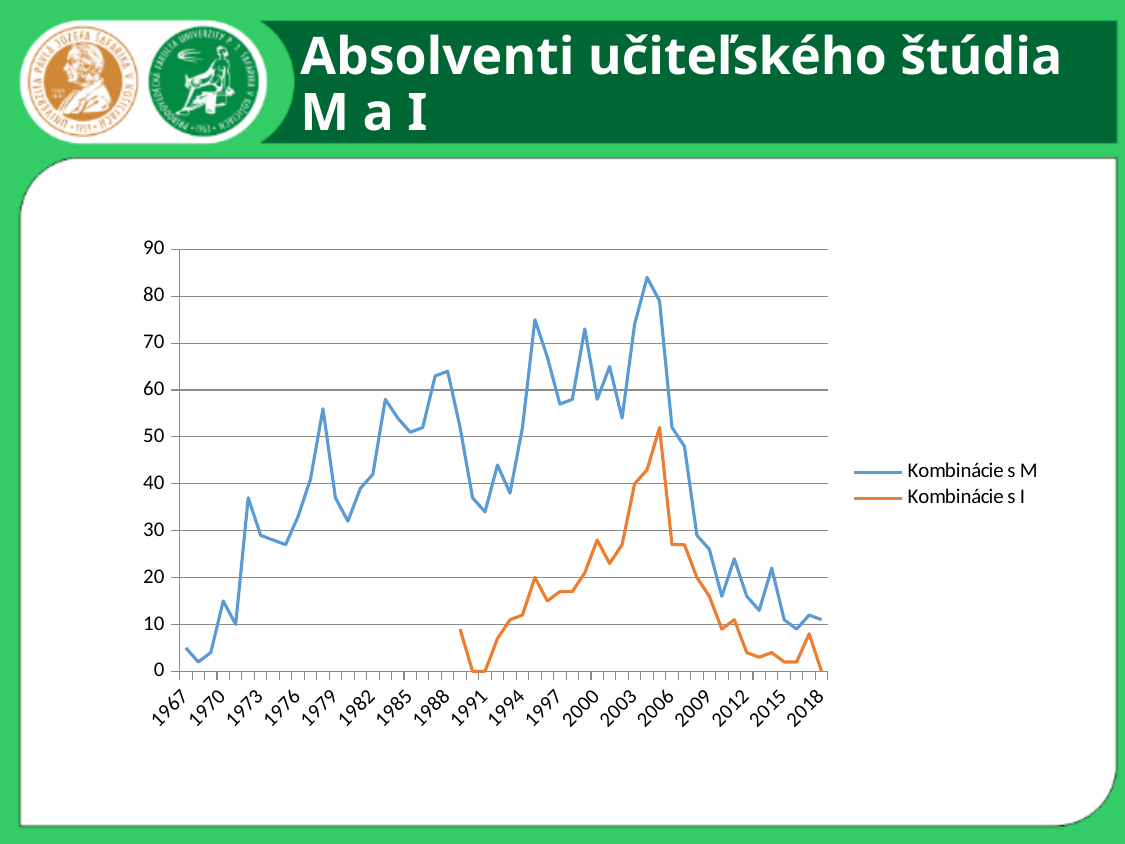
Does the Kombinácie s I series generally rise or fall between 1991 and 2005? rise What are the two series named in the legend? Kombinácie s M and Kombinácie s I Is the highest value of the Kombinácie s M series greater or less than 80? greater What kind of chart is shown on the slide? line chart Is the value for Kombinácie s I in 2018 greater or less than 10? less How many series does the legend list? 2 Is the value for Kombinácie s M in 1967 greater or less than 10? less Which series reaches the higher peak value, Kombinácie s M or Kombinácie s I? Kombinácie s M What is the title of the chart on the slide? Absolventi učiteľského štúdia M a I In 2006, which series has the higher value, Kombinácie s M or Kombinácie s I? Kombinácie s M Does the Kombinácie s M series generally rise or fall between 2006 and 2018? fall